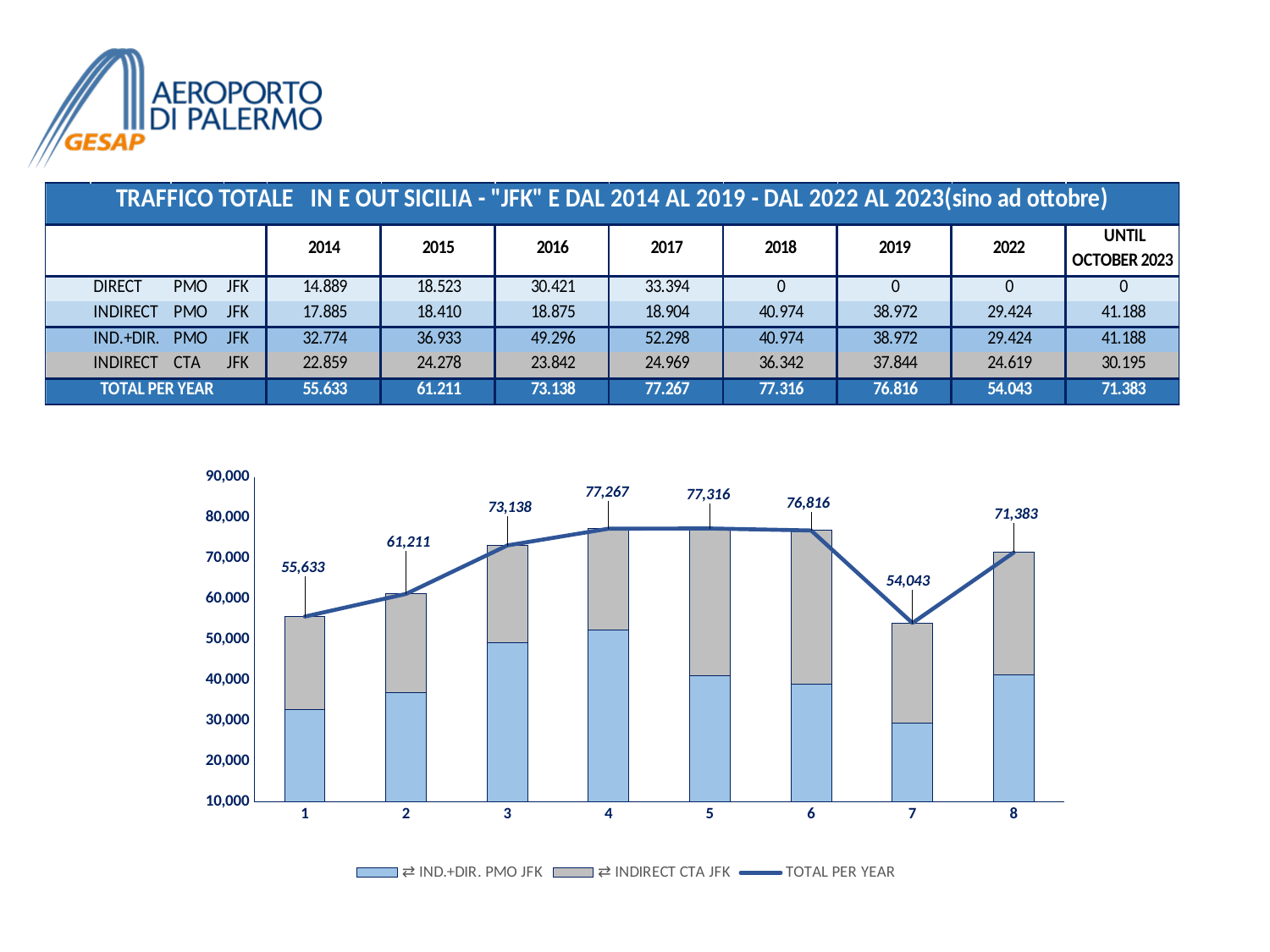
What is the difference between the TOTAL PER YEAR values at category 5 and category 7? 23,273 Is the IND.+DIR. PMO JFK value for category 1 greater or less than 40,000? less What is the TOTAL PER YEAR value shown at category 1 on the chart? 55,633 Does the TOTAL PER YEAR line rise or fall from category 6 to category 7? fall How many series does the chart legend list? 3 How many categories are shown on the x axis of the chart? 8 What is the TOTAL PER YEAR value shown at category 8 on the chart? 71,383 Which category has the highest TOTAL PER YEAR value on the chart? 5 Which has a larger TOTAL PER YEAR value, category 2 or category 3? 3 What is the TOTAL PER YEAR value shown at category 7 on the chart? 54,043 Which category has the lowest TOTAL PER YEAR value on the chart? 7 What kind of chart is shown on the slide? combination bar and line chart